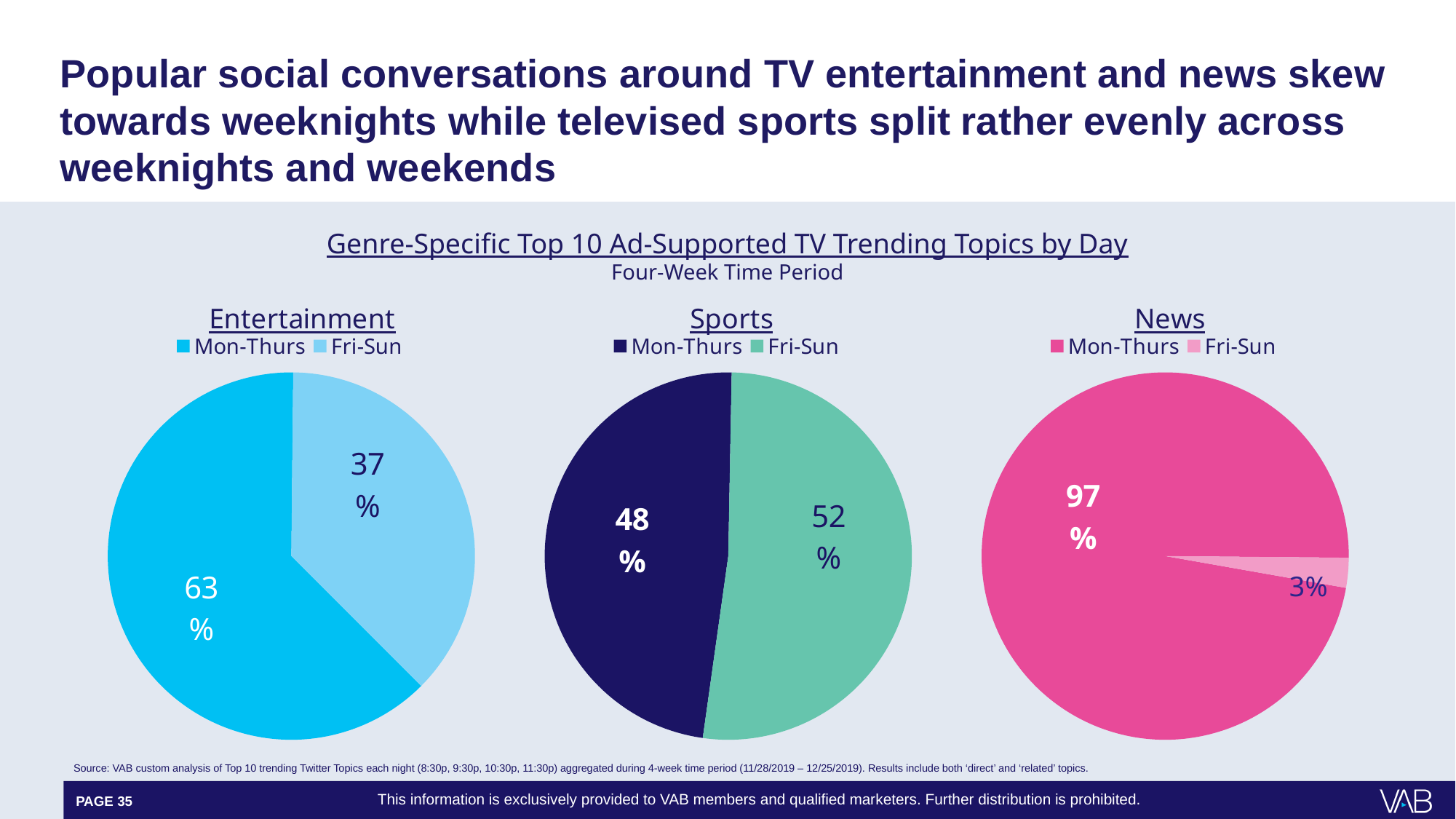
In the News pie chart, what is the value for Fri-Sun? 3% In the Entertainment pie chart, what is the difference between the Mon-Thurs and Fri-Sun values? 26% In the Sports pie chart, what is the value for Mon-Thurs? 48% In the Sports pie chart, what is the value for Fri-Sun? 52% In the News pie chart, what is the value for Mon-Thurs? 97% In the Sports pie chart, which is larger, Mon-Thurs or Fri-Sun? Fri-Sun How many series does the legend of the News chart list? 2 What type of chart is used for the Sports data? Pie chart In the Entertainment pie chart, which slice is the smallest? Fri-Sun In the News pie chart, which slice is the largest? Mon-Thurs In the Entertainment pie chart, what is the value for Mon-Thurs? 63% In the Entertainment pie chart, what is the value for Fri-Sun? 37%